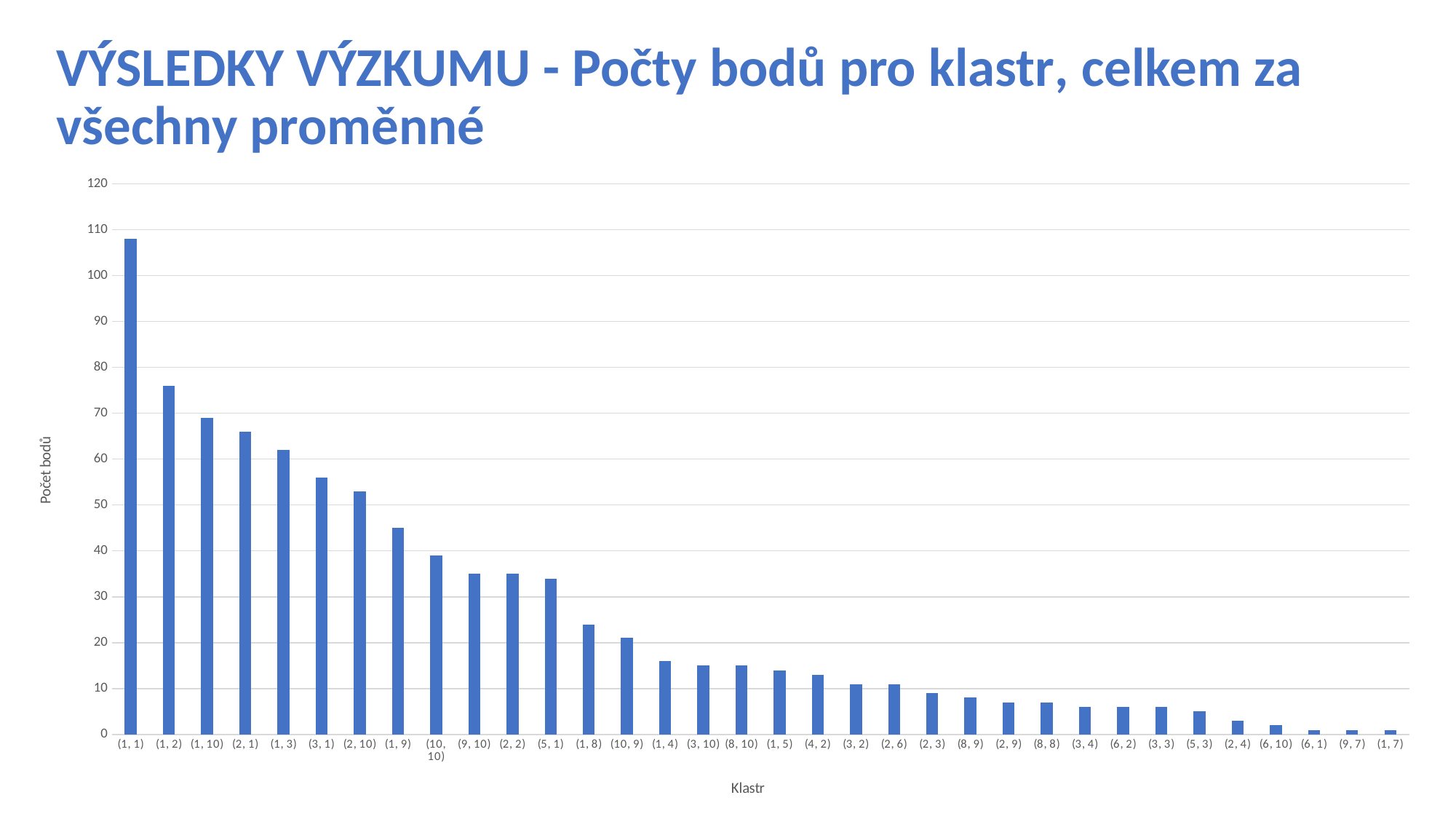
Is the value for cluster (1, 9) greater or less than 40? greater Which cluster has a larger value, (1, 2) or (1, 10)? (1, 2) What is the title of the vertical axis? Počet bodů Is the value for cluster (1, 8) greater or less than 20? greater How many clusters are shown on the x axis? 34 Is the value for cluster (1, 1) greater or less than 100? greater What kind of chart is shown on the slide? bar chart Which cluster has the highest number of points? (1, 1) Do the values rise or fall from left to right along the x axis? fall